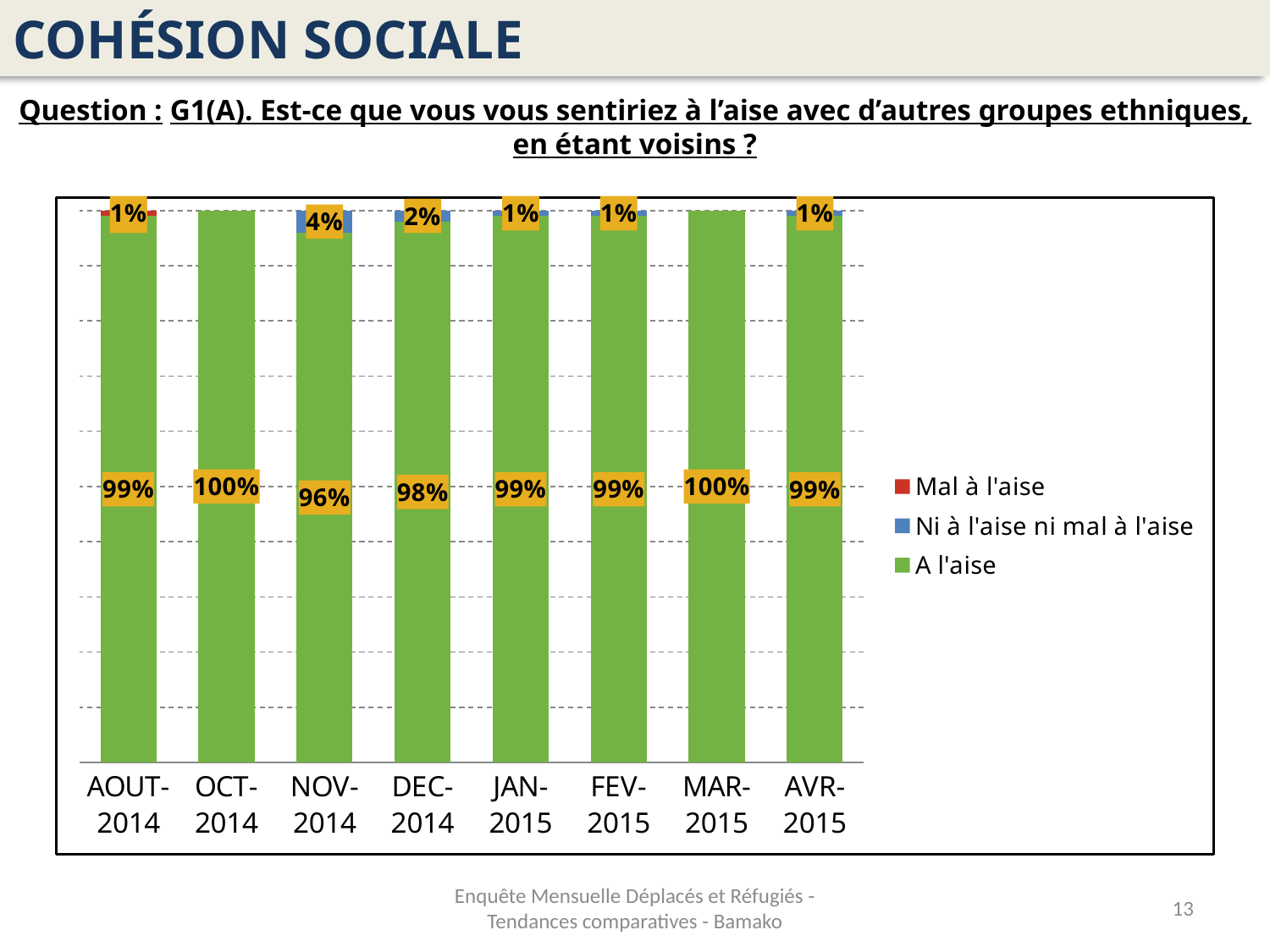
What is the value for "Ni à l'aise ni mal à l'aise" in NOV-2014? 4% How many series does the legend list? 3 Which month has the larger "A l'aise" value, DEC-2014 or JAN-2015? JAN-2015 What is the difference in percentage points between the "A l'aise" value in OCT-2014 and in NOV-2014? 4 What is the value for "A l'aise" in DEC-2014? 98% What kind of chart is shown on the slide? Stacked bar chart What is the value for "A l'aise" in NOV-2014? 96% What is the value for "Ni à l'aise ni mal à l'aise" in DEC-2014? 2% How many months show an "A l'aise" value of 100%? 2 What is the value for "A l'aise" in AVR-2015? 99% How many months are shown on the x axis? 8 In which month is the "A l'aise" value lowest? NOV-2014